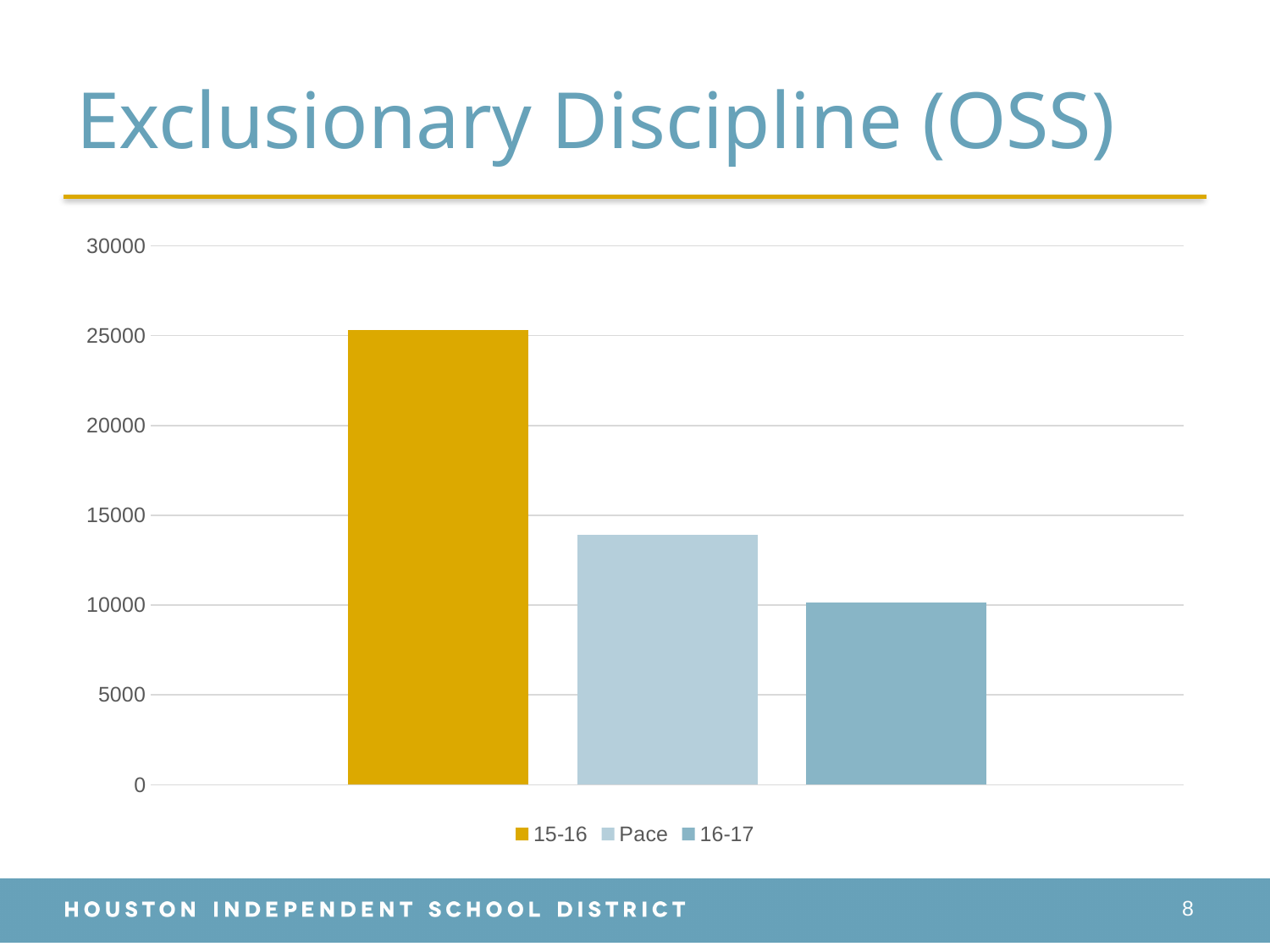
Is the value for 16-17 greater or less than 15000? less What colour is the bar for 15-16? gold What kind of chart is shown on the slide? bar chart Which is larger, the value for 15-16 or the value for Pace? 15-16 How many bars are plotted in the chart? 3 Is the value for 15-16 greater or less than 20000? greater Which series has the lowest value? 16-17 Which is larger, the value for Pace or the value for 16-17? Pace Is the value for Pace greater or less than 15000? less Which series has the highest value? 15-16 What is the title of the slide containing the chart? Exclusionary Discipline (OSS) How many series does the legend list? 3